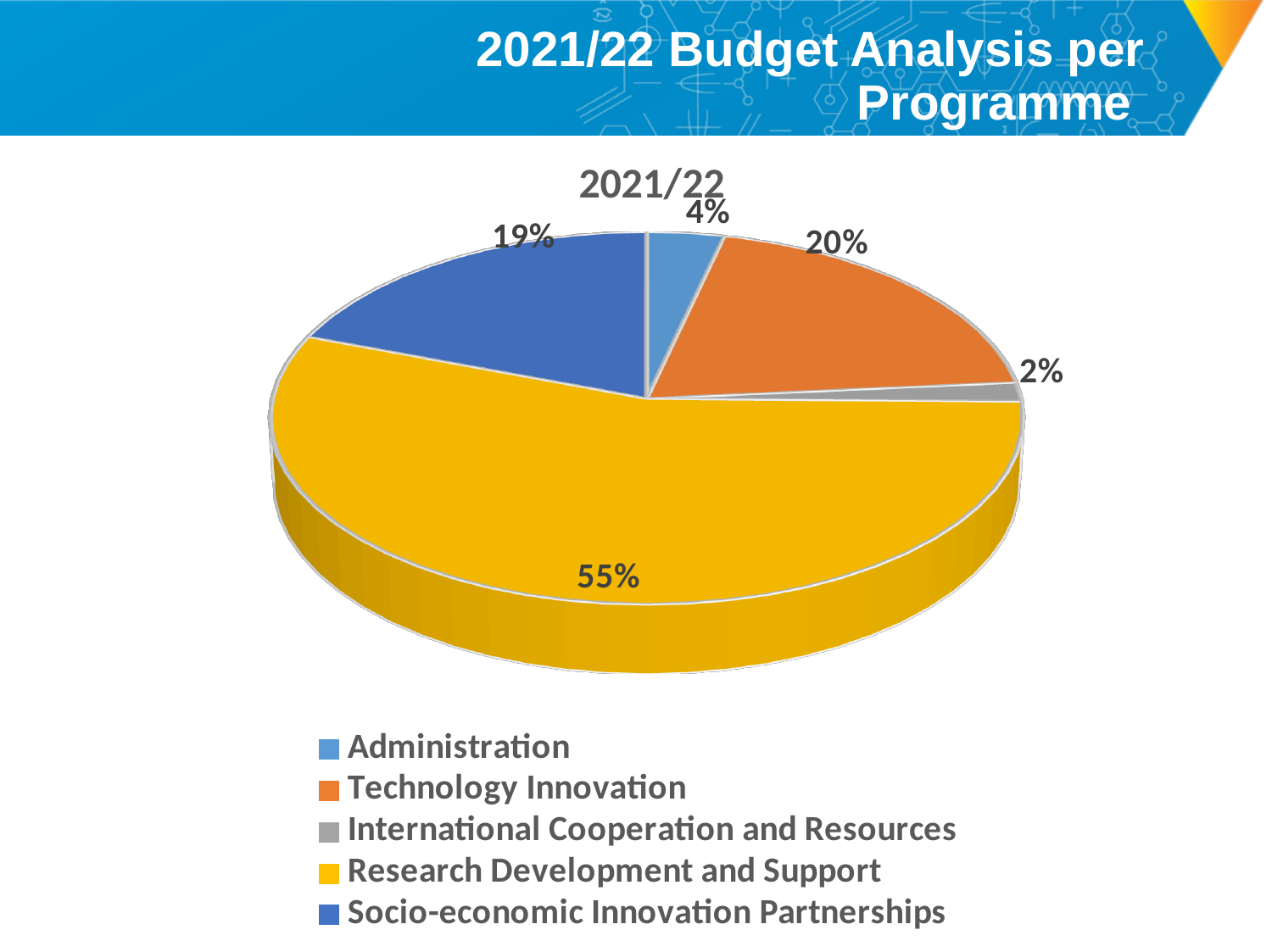
Which programme has the largest share of the 2021/22 budget? Research Development and Support What share of the 2021/22 budget goes to Socio-economic Innovation Partnerships? 19% What type of chart is shown on the slide? Pie chart What share of the 2021/22 budget goes to Administration? 4% How many programmes are shown in the pie chart? 5 What share of the 2021/22 budget goes to Technology Innovation? 20% Which has a larger share of the budget, Technology Innovation or Socio-economic Innovation Partnerships? Technology Innovation Which programme has the smallest share of the 2021/22 budget? International Cooperation and Resources What is the title shown above the pie chart? 2021/22 What is the difference in percentage points between the Research Development and Support share and the Technology Innovation share? 35